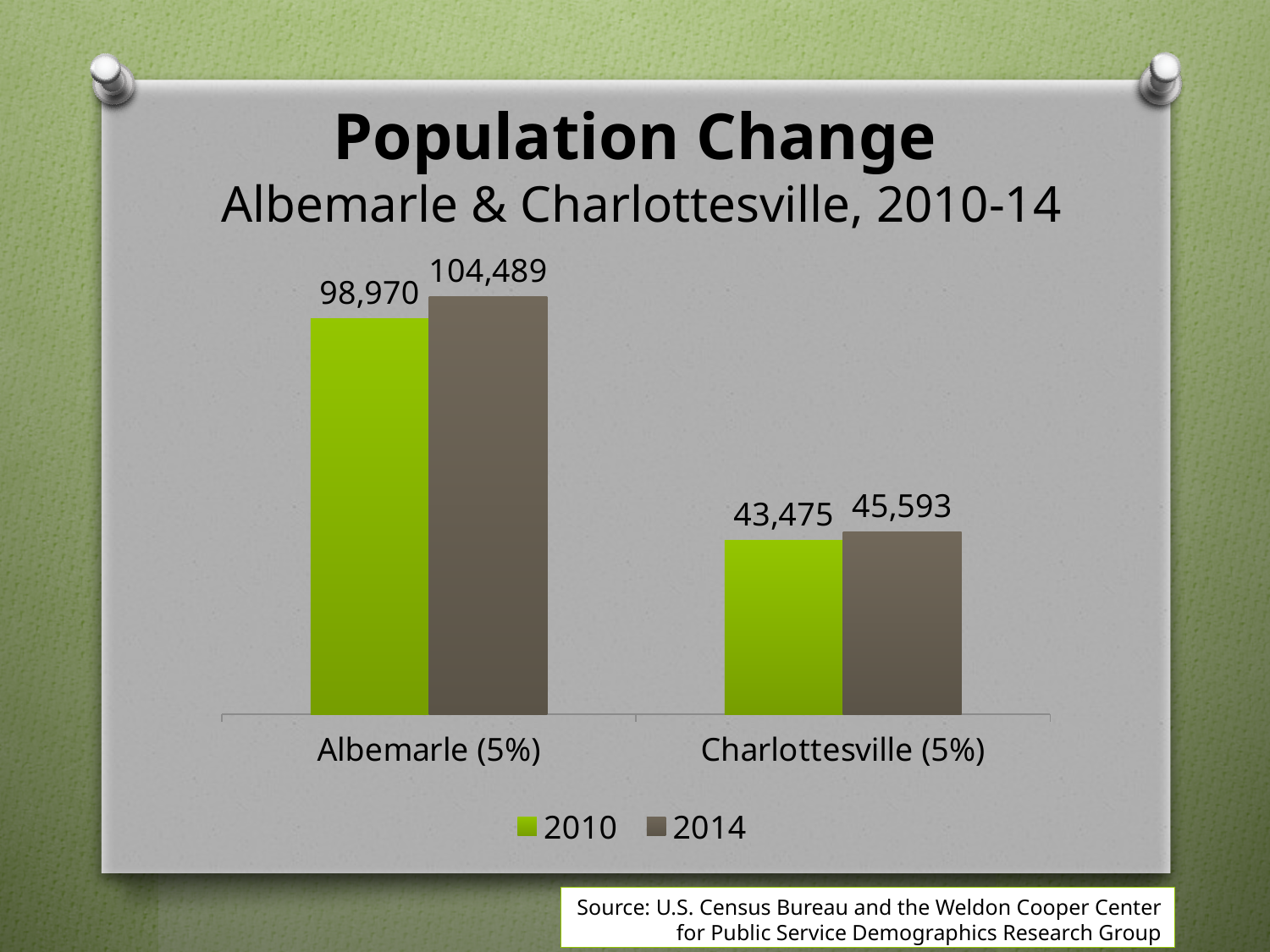
By how much did Charlottesville's population increase from 2010 to 2014? 2,118 What was the population of Albemarle in 2014? 104,489 How many series does the legend list? 2 What kind of chart is shown on the slide? Bar chart Which had the larger population in 2014, Albemarle or Charlottesville? Albemarle What was the population of Albemarle in 2010? 98,970 Which bar shows the highest value on the chart? Albemarle, 2014 By how much did Albemarle's population increase from 2010 to 2014? 5,519 Which bar shows the lowest value on the chart? Charlottesville, 2010 What was the population of Charlottesville in 2010? 43,475 How many categories are shown on the x axis? 2 What was the population of Charlottesville in 2014? 45,593